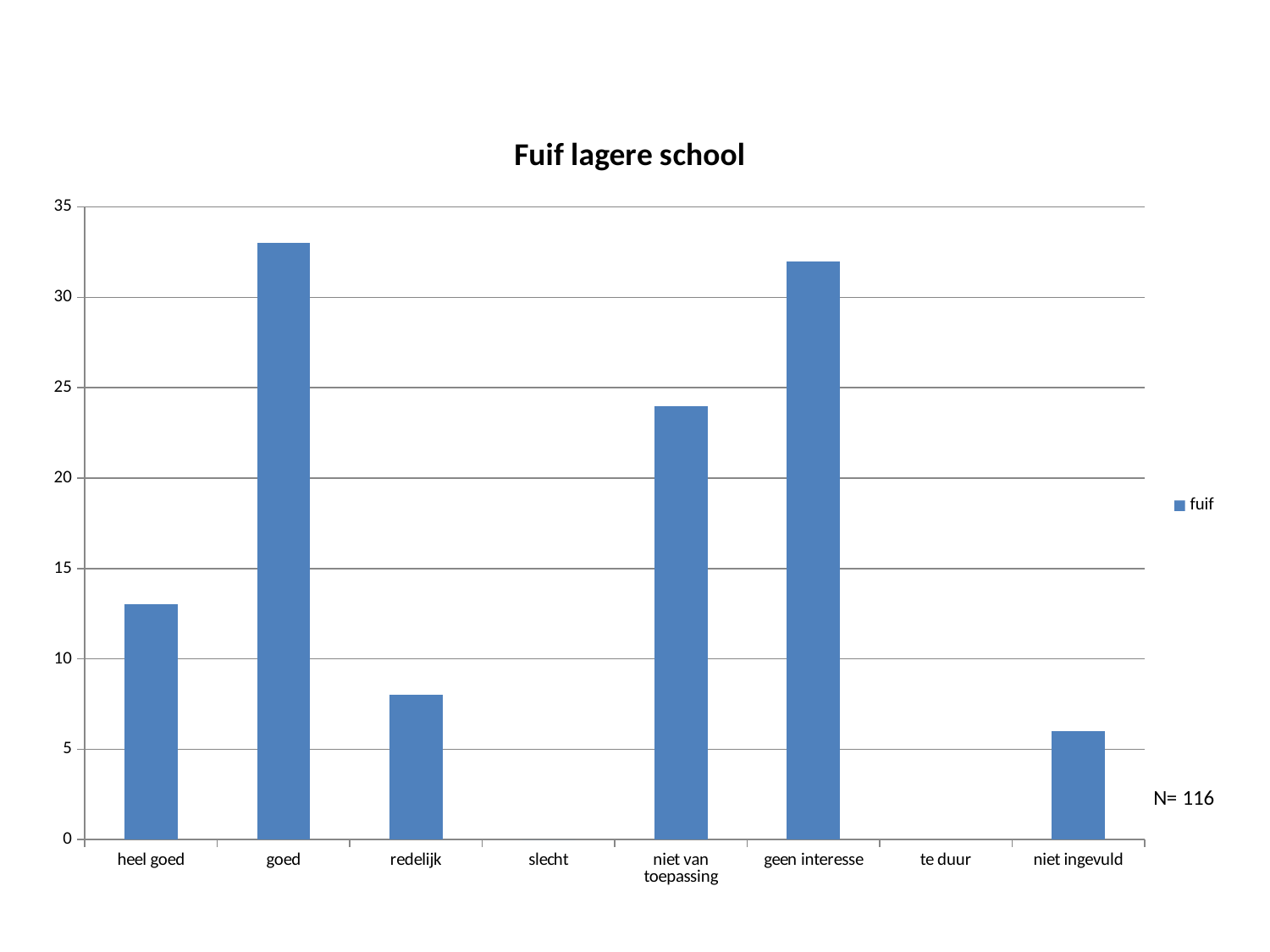
What kind of chart is shown on the slide? bar chart Is the value for niet ingevuld greater or less than 10? less Which is larger, the value for goed or the value for heel goed? goed Is the value for geen interesse greater or less than 30? greater Which is larger, the value for niet van toepassing or the value for redelijk? niet van toepassing Is the value for redelijk greater or less than 10? less How many categories are shown on the x axis? 8 What is the title of the chart? Fuif lagere school How many series does the legend list? 1